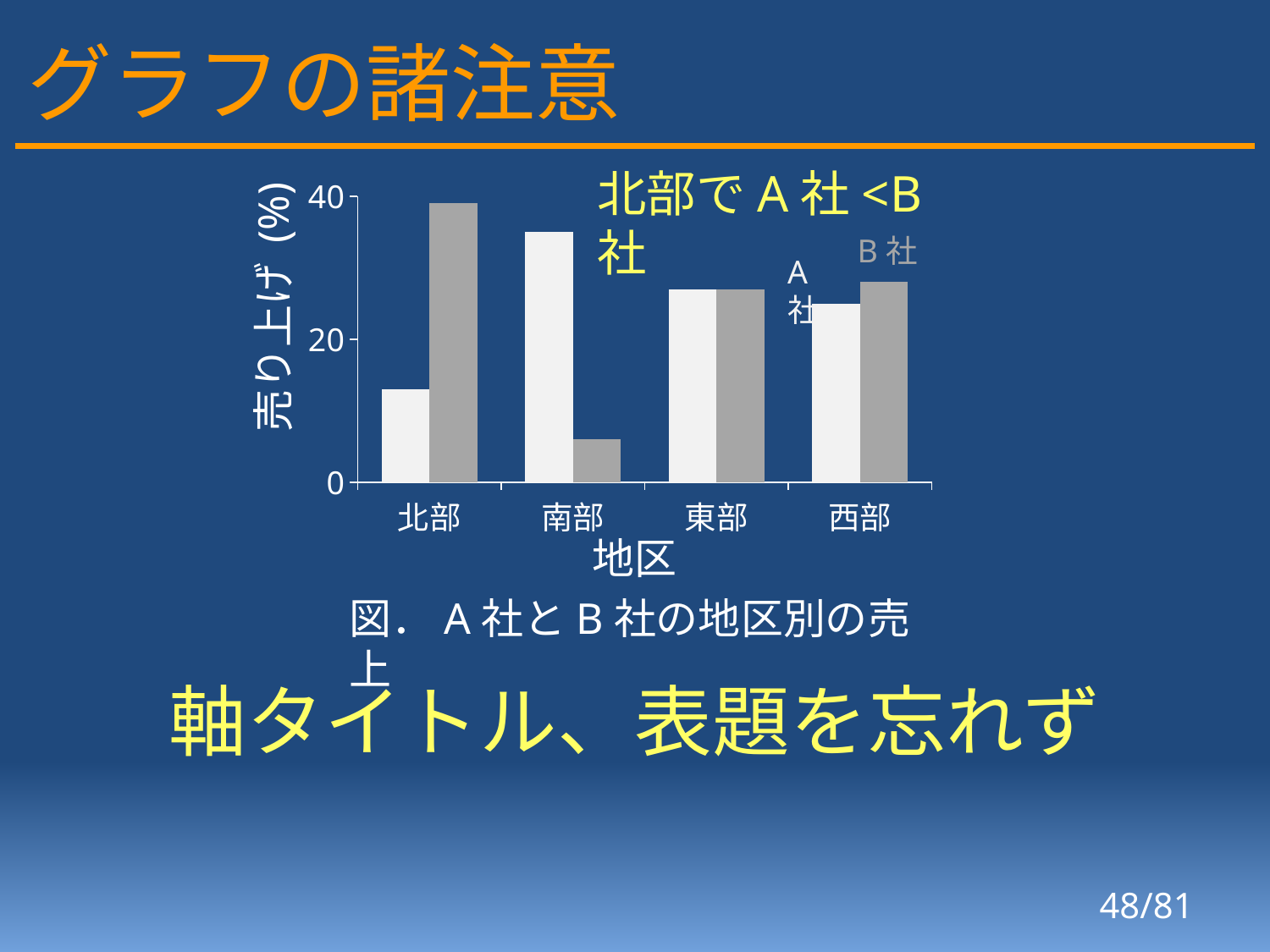
Which region has the lowest value for B社? 南部 Which region has the highest value for A社? 南部 In 北部, which company has the larger value, A社 or B社? B社 Is the value for A社 in 北部 greater or less than 20? less In 南部, which company has the larger value, A社 or B社? A社 How many series does the chart show? 2 Which region has the lowest value for A社? 北部 How many regions (categories) are shown on the x axis of the chart? 4 Which region has the highest value for B社? 北部 Is the value for B社 in 北部 greater or less than 20? greater What is the title of the x axis of the chart? 地区 What kind of chart is shown on the slide? bar chart